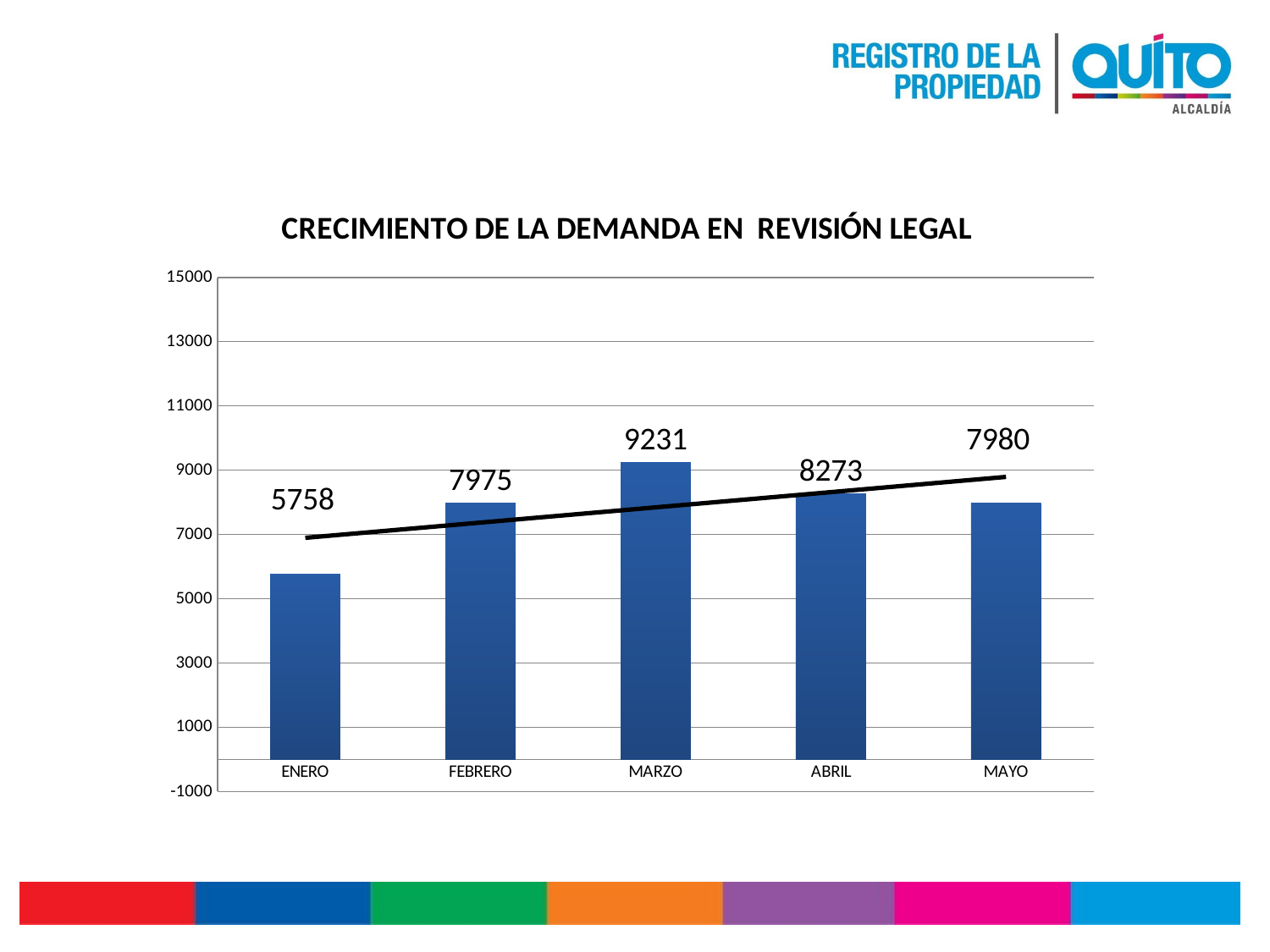
What is the difference between the values for MARZO and ENERO? 3473 Which month has the lowest value? ENERO What is the value for ABRIL? 8273 What kind of chart is this? bar chart Which month has the highest value? MARZO Which is larger, the value for ABRIL or the value for ENERO? ABRIL Do the values rise or fall from ENERO to MARZO? rise What is the value for ENERO? 5758 What is the difference between the values for MARZO and ABRIL? 958 What is the value for MARZO? 9231 How many months are shown on the x axis? 5 Is the value for ENERO greater or less than 7000? less